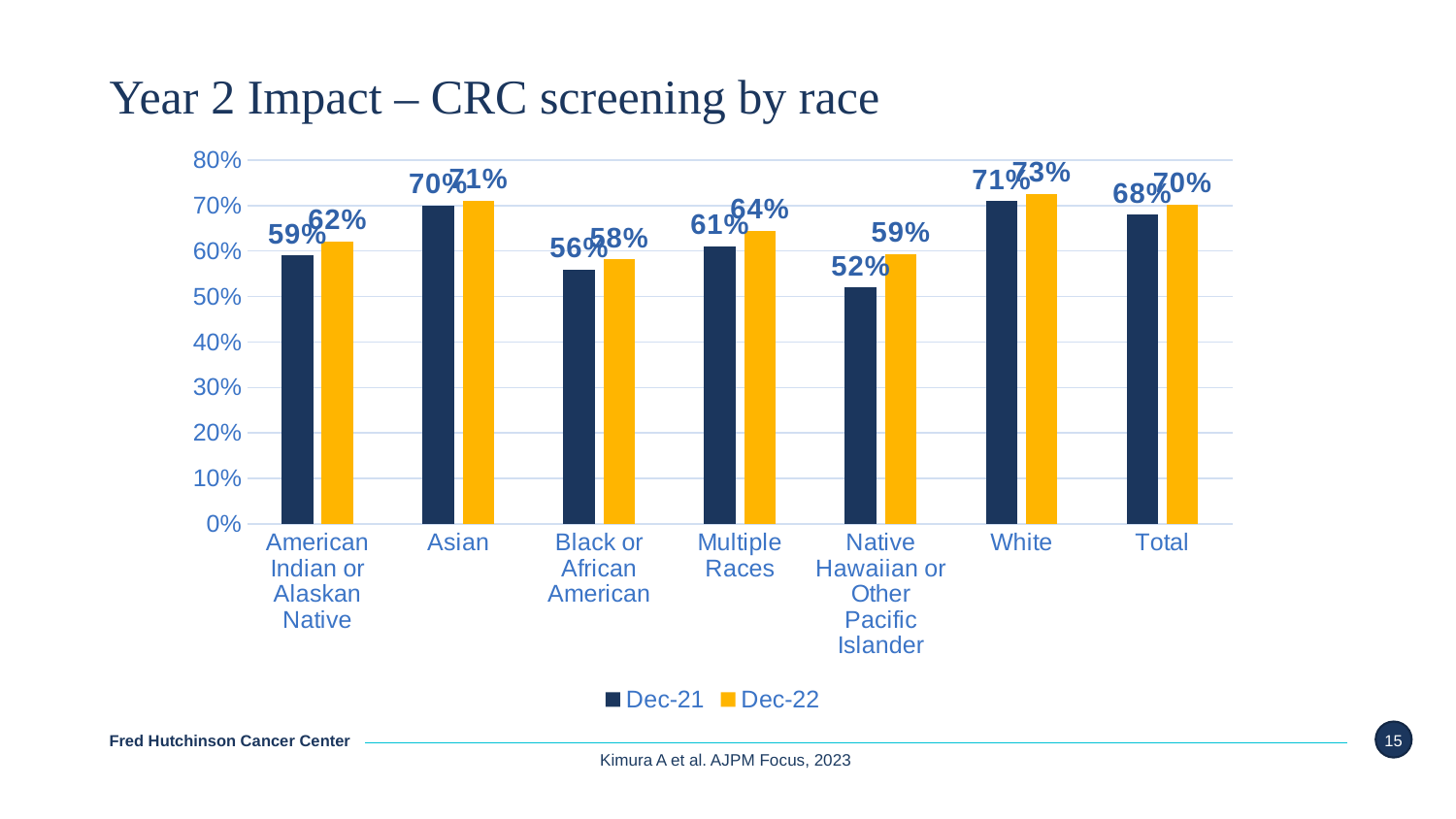
How many race categories (including Total) are shown on the x axis? 7 What is the Dec-22 value for White? 73% What is the Dec-21 value for Multiple Races? 61% What type of chart is shown on the slide? bar chart Which category has the highest Dec-22 value? White Which category has the lowest Dec-21 value? Native Hawaiian or Other Pacific Islander How many series does the legend list? 2 Is the Dec-21 value for Native Hawaiian or Other Pacific Islander greater or less than 60%? less What is the title of the chart? Year 2 Impact – CRC screening by race What is the difference between the Dec-22 and Dec-21 values for Native Hawaiian or Other Pacific Islander? 7% What is the Dec-22 value for Native Hawaiian or Other Pacific Islander? 59% Which is larger, the Dec-21 value for Asian or the Dec-21 value for Black or African American? Asian